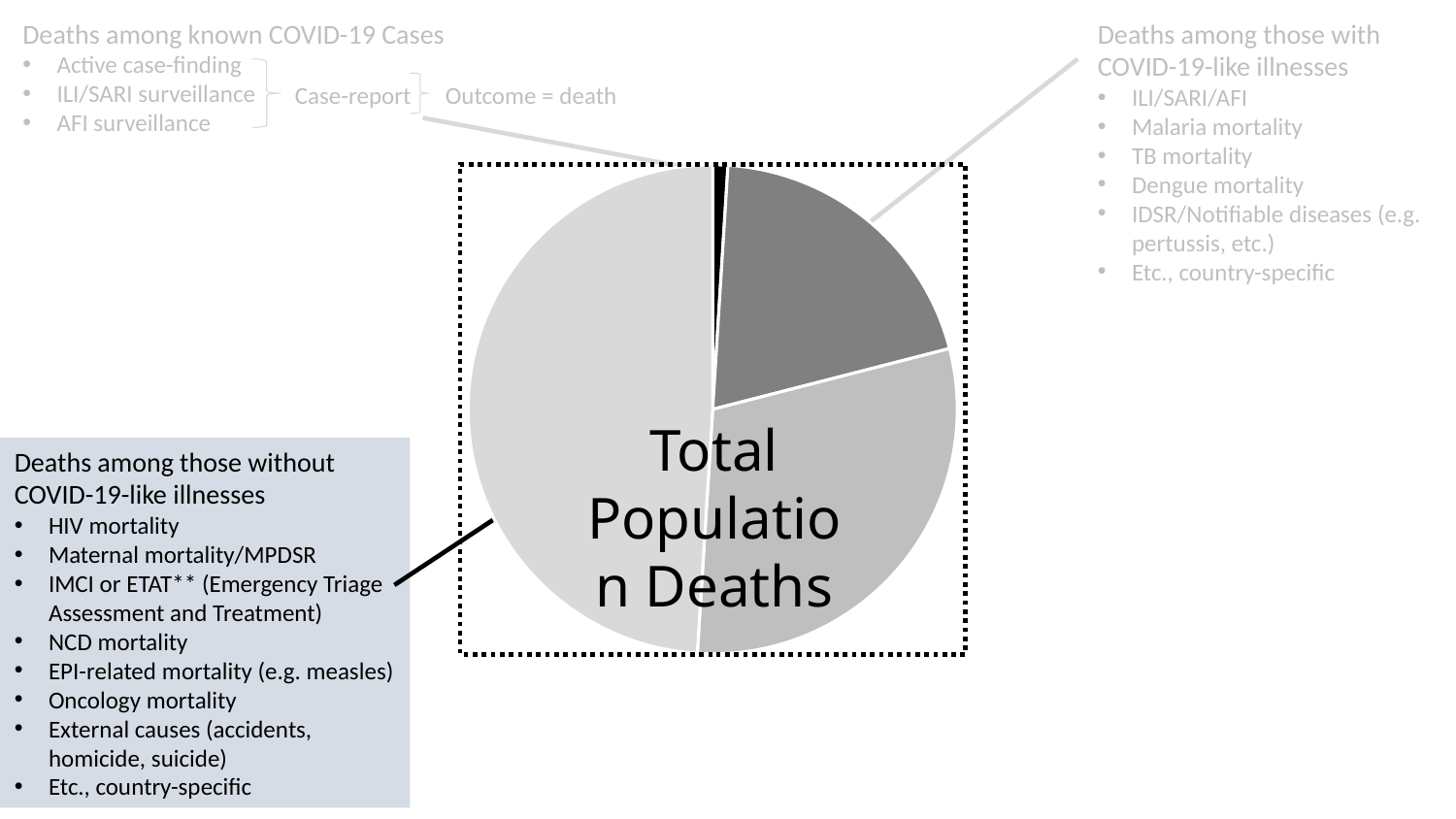
Which category has the largest slice of the pie chart? Deaths among those without COVID-19-like illnesses How many slices does the pie chart have? 4 Which slice is larger: deaths among known COVID-19 cases or deaths among those with COVID-19-like illnesses? Deaths among those with COVID-19-like illnesses What kind of chart is shown on the slide? Pie chart Does the pie chart show a legend? No Which slice is larger: deaths among those with COVID-19-like illnesses or deaths among those without COVID-19-like illnesses? Deaths among those without COVID-19-like illnesses Which category has the smallest slice of the pie chart? Deaths among known COVID-19 Cases What is the title written on the pie chart? Total Population Deaths